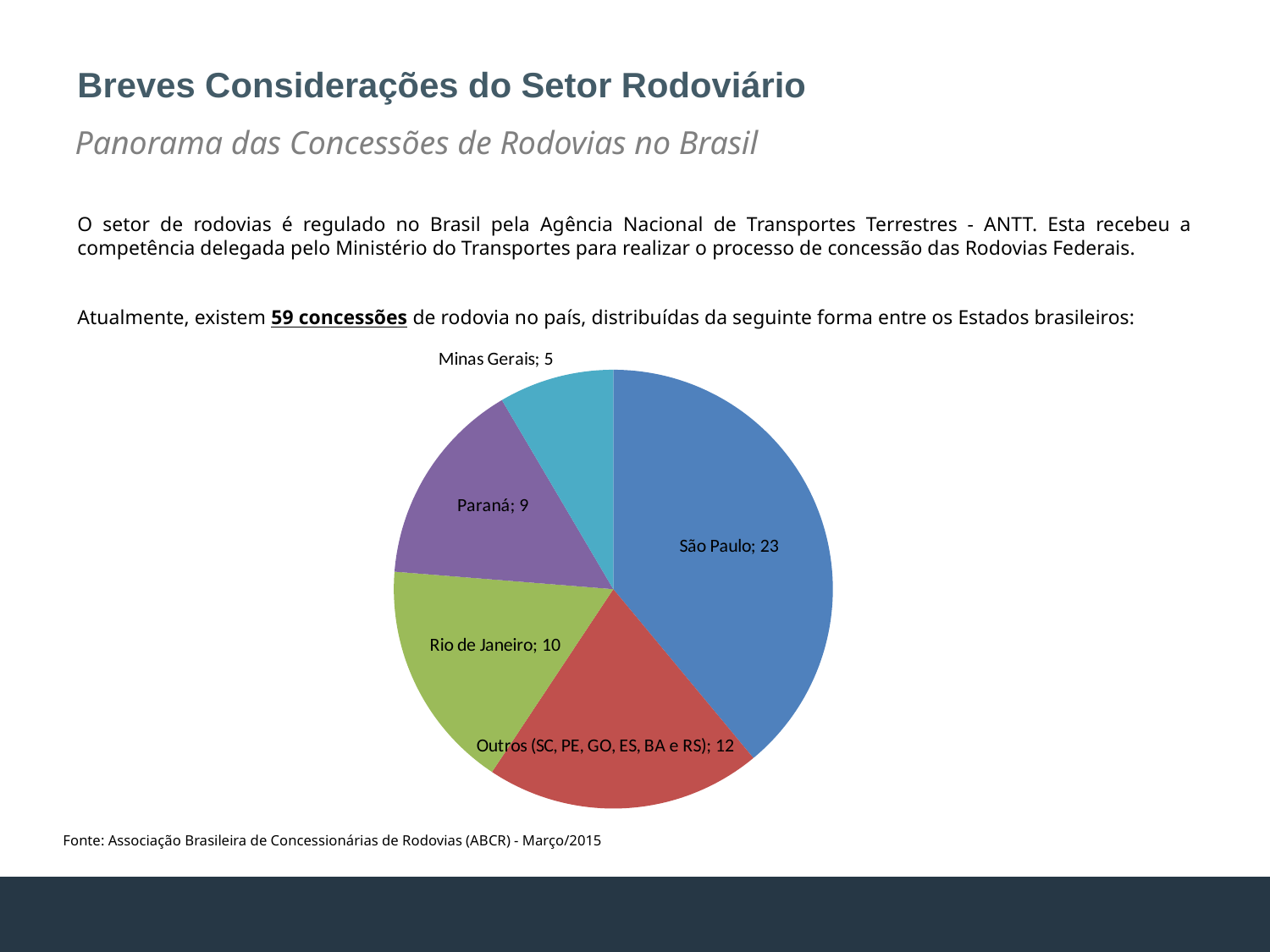
How many concessions does the pie chart show for São Paulo? 23 Which slice of the pie chart is the largest? São Paulo Which has a larger value, Paraná or Rio de Janeiro? Rio de Janeiro How many slices does the pie chart have? 5 What is the value shown for Rio de Janeiro in the pie chart? 10 What is the difference between the values for São Paulo and Rio de Janeiro? 13 What kind of chart is shown on the slide? pie chart What is the value shown for Paraná in the pie chart? 9 What is the value shown for the slice labelled Outros (SC, PE, GO, ES, BA e RS)? 12 What share of the total 59 concessions does São Paulo represent, to the nearest percent? 39% What is the value shown for Minas Gerais in the pie chart? 5 Which slice of the pie chart is the smallest? Minas Gerais